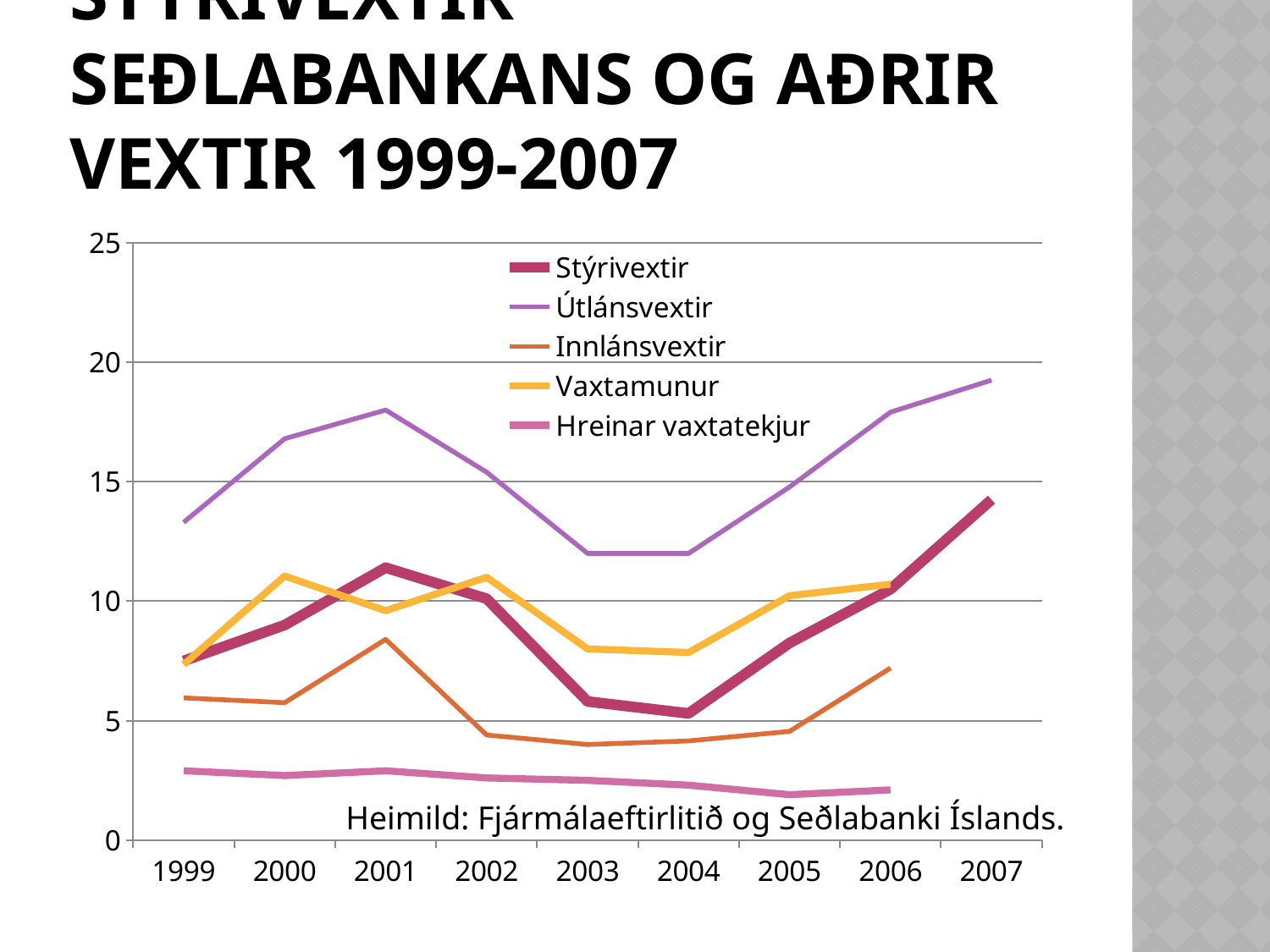
Does the Útlánsvextir line rise or fall from 2004 to 2007? rise How many years are shown on the x axis? 9 Does the Stýrivextir line rise or fall from 2001 to 2004? fall What kind of chart is shown on the slide? line chart Which series has the highest value in 2007? Útlánsvextir In 2003, which is larger: Innlánsvextir or Vaxtamunur? Vaxtamunur In which year is Stýrivextir at its highest? 2007 Which series has the lowest values across all years shown? Hreinar vaxtatekjur How many series does the legend list? 5 Is the value for Innlánsvextir in 2001 greater or less than 5? greater Is the value for Útlánsvextir in 2001 greater or less than 15? greater Is the value for Stýrivextir in 2004 greater or less than 10? less